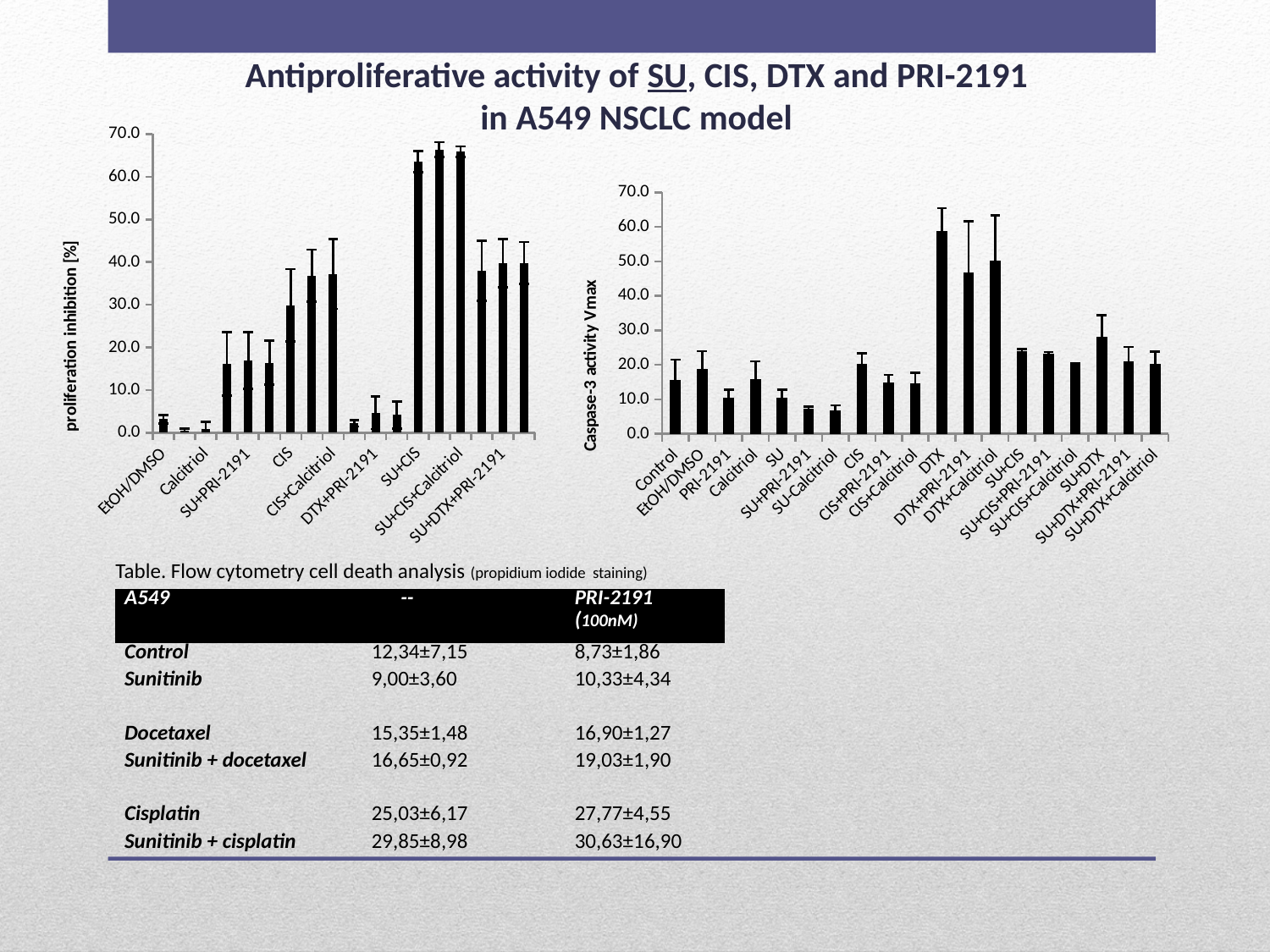
In the left chart (proliferation inhibition [%]), is the value for DTX+PRI-2191 greater or less than 10.0? less What is the y-axis title of the left chart? proliferation inhibition [%] In the right chart (Caspase-3 activity Vmax), is the value for SU+DTX greater or less than 20.0? greater In the left chart (proliferation inhibition [%]), is the value for CIS+Calcitriol greater or less than 30.0? greater How many categories are shown on the x axis of the right chart (Caspase-3 activity Vmax)? 19 In the right chart (Caspase-3 activity Vmax), which is larger, the value for DTX or the value for CIS? DTX What kind of chart is the left chart (proliferation inhibition [%])? bar chart In the left chart (proliferation inhibition [%]), which is larger, the value for SU+CIS or the value for CIS? SU+CIS In the right chart (Caspase-3 activity Vmax), which category has the highest value? DTX